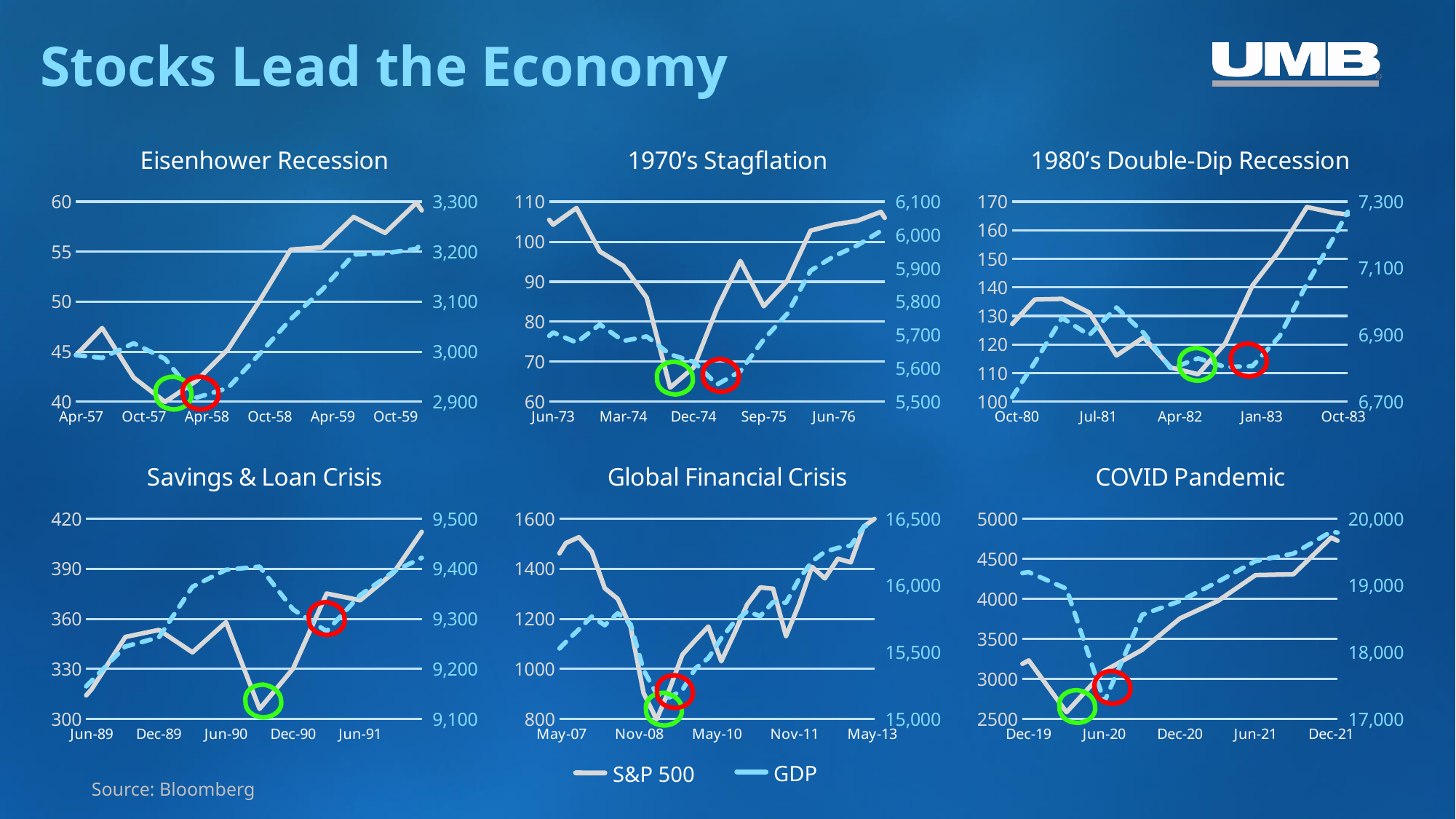
How many series does the legend at the bottom of the slide list? 2 In the Global Financial Crisis chart, is the S&P 500 value at May-07 greater or less than 1400? greater In the COVID Pandemic chart, does the S&P 500 line rise or fall from Jun-20 to Dec-21? rise In the 1980's Double-Dip Recession chart, is the S&P 500 value at Oct-83 greater or less than 150? greater In the Eisenhower Recession chart, is the S&P 500 value at Oct-59 greater or less than 55? greater What source is cited for the charts on the slide? Bloomberg In the 1970's Stagflation chart, does the S&P 500 line rise or fall from Jun-73 to Dec-74? fall How many charts are shown on the slide? 6 What are the two series named in the legend? S&P 500 and GDP What kind of chart is the Eisenhower Recession chart? line chart